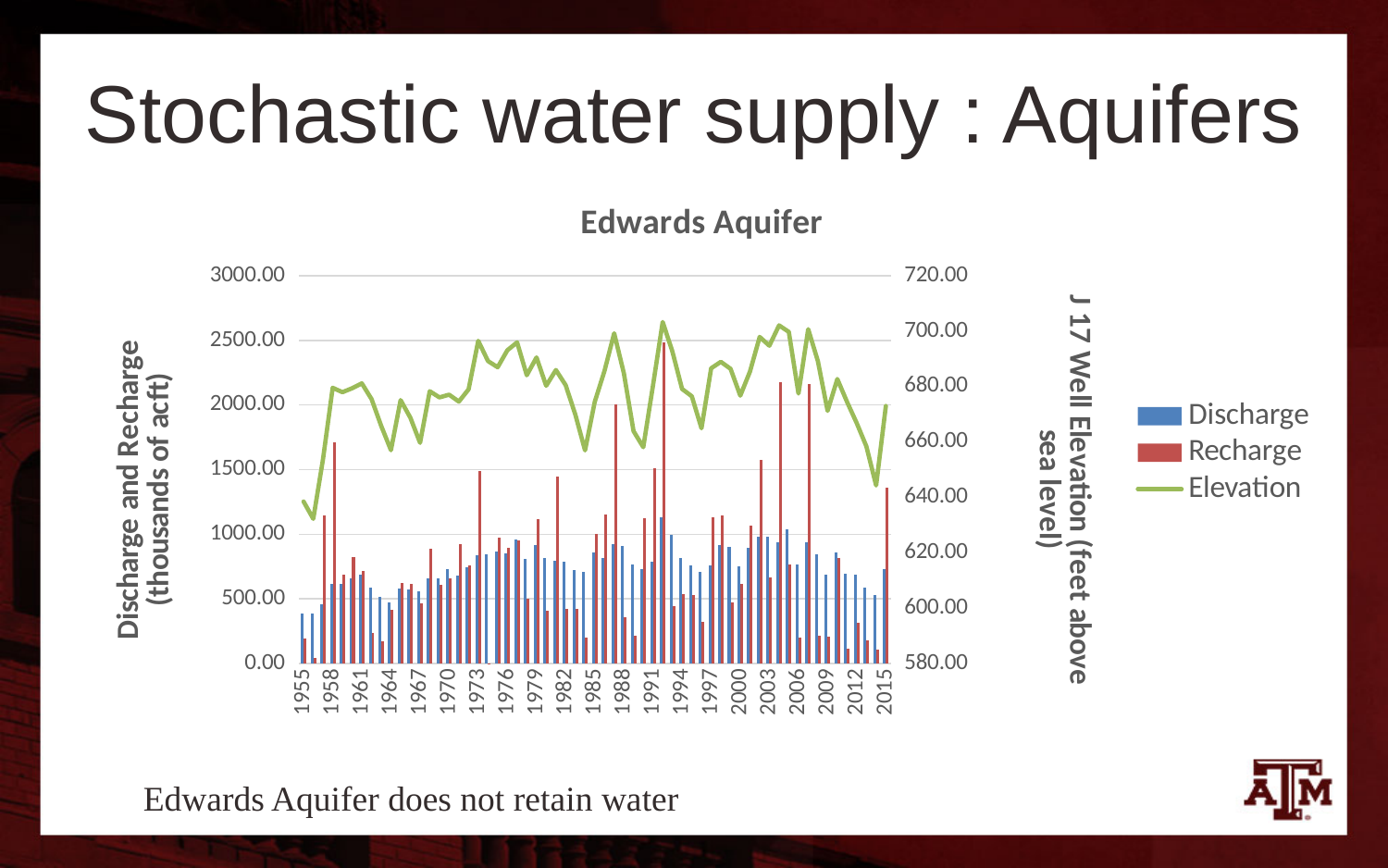
Does the Elevation line rise or fall between 1956 and 1958? rise How many series does the chart legend list? 3 Is the Elevation value for 2014 greater or less than 660? less In which year is the Recharge bar highest? 1992 Which is larger, the Recharge value for 1992 or the Recharge value for 1958? 1992 Is the Recharge value for 1958 greater or less than 1500? greater Is the Recharge value for 1992 greater or less than 2000? greater Which series in the chart is plotted as a line rather than bars? Elevation What kind of chart is shown on the slide? Combined bar and line chart Does the Elevation line rise or fall between 2007 and 2014? fall What is the title of the chart? Edwards Aquifer